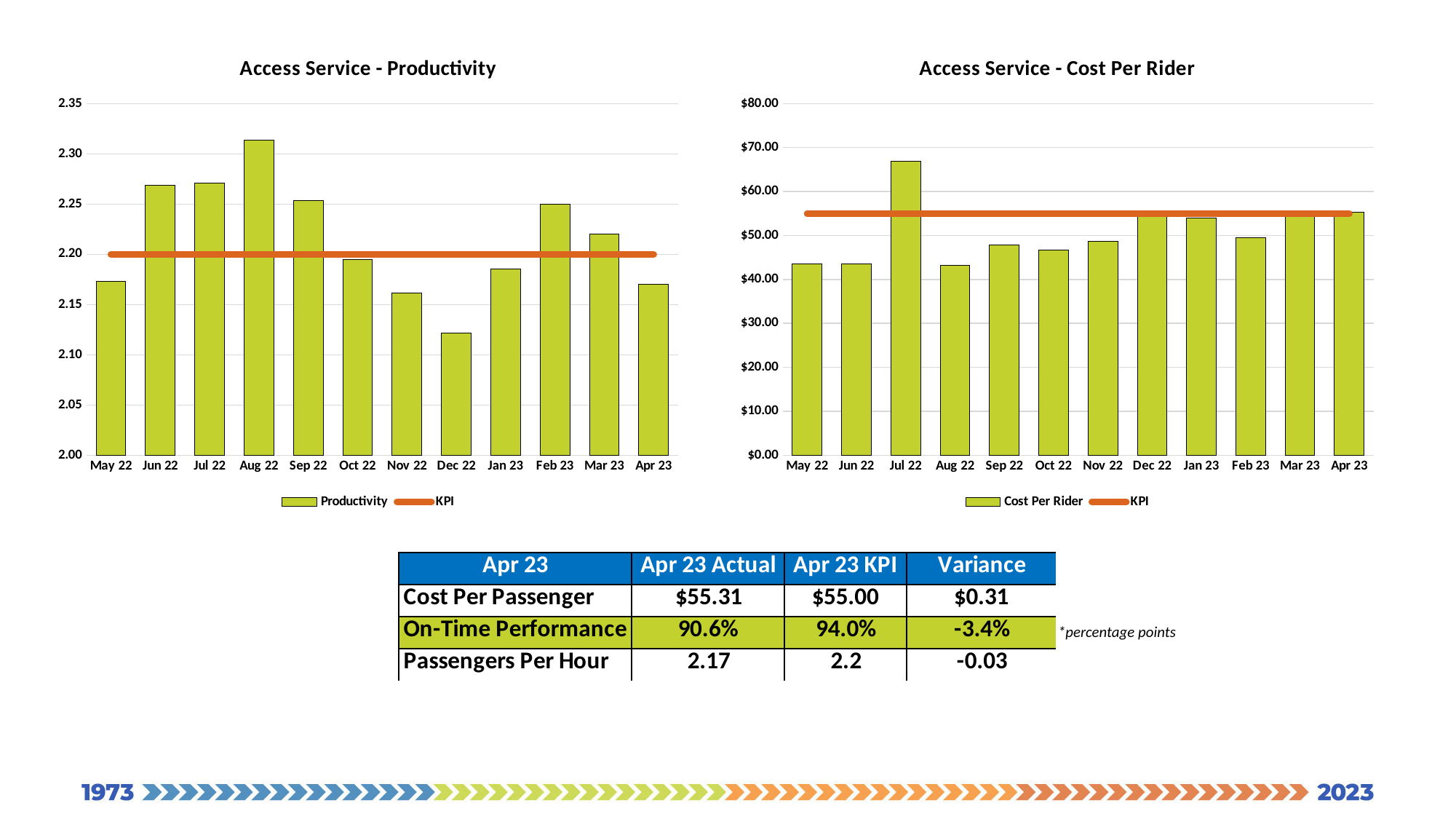
In the Access Service - Productivity chart, is the value for Nov 22 greater or less than 2.20? less In the Access Service - Cost Per Rider chart, which month has the highest cost per rider? Jul 22 In the Access Service - Productivity chart, is the productivity bar for Feb 23 higher or lower than the bar for Jan 23? higher What colour is the KPI line in the Access Service - Productivity chart? orange In the Access Service - Cost Per Rider chart, do the bars rise or fall from Aug 22 to Dec 22? rise In the Access Service - Cost Per Rider chart, is the bar for Jul 22 higher or lower than the bar for Feb 23? higher How many series does the legend of the Access Service - Cost Per Rider chart list? 2 In the Access Service - Productivity chart, which month has the lowest productivity bar? Dec 22 How many months are shown on the x axis of the Access Service - Productivity chart? 12 In the Access Service - Productivity chart, which month has the highest productivity bar? Aug 22 What kind of chart is the Access Service - Productivity chart? bar chart In the Access Service - Cost Per Rider chart, is the value for Jul 22 greater or less than $60.00? greater